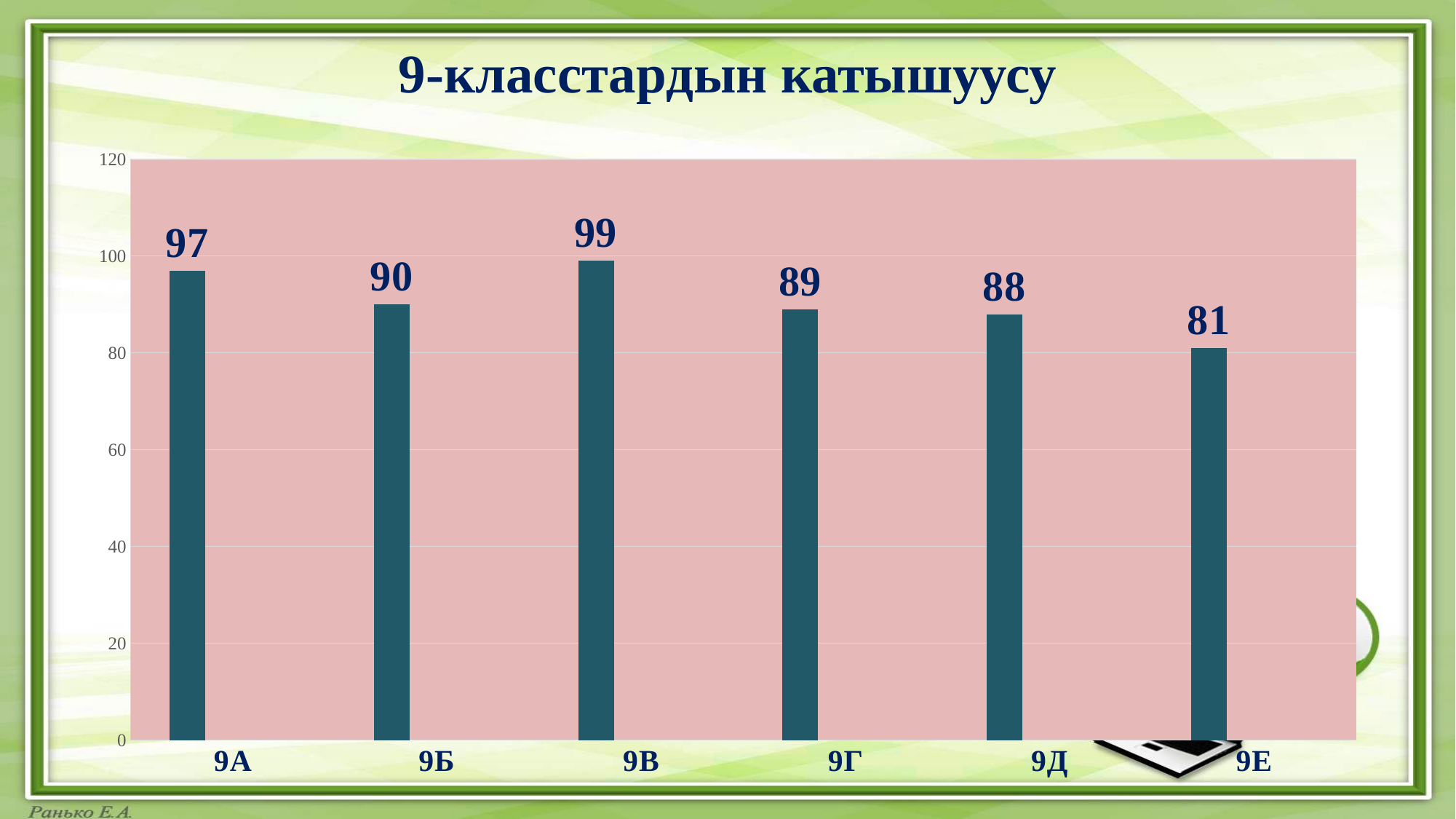
How many categories are shown on the x axis? 6 Which is larger, the value for 9Б or the value for 9Д? 9Б Which category has the lowest value? 9Е What kind of chart is shown on the slide? bar chart What is the value for 9А? 97 What is the value for 9Е? 81 What is the difference between the values for 9В and 9Е? 18 What is the title of the chart? 9-класстардын катышуусу What is the value for 9Г? 89 Which category has the highest value? 9В Is the value for 9Д greater or less than 100? less What is the difference between the values for 9А and 9Б? 7